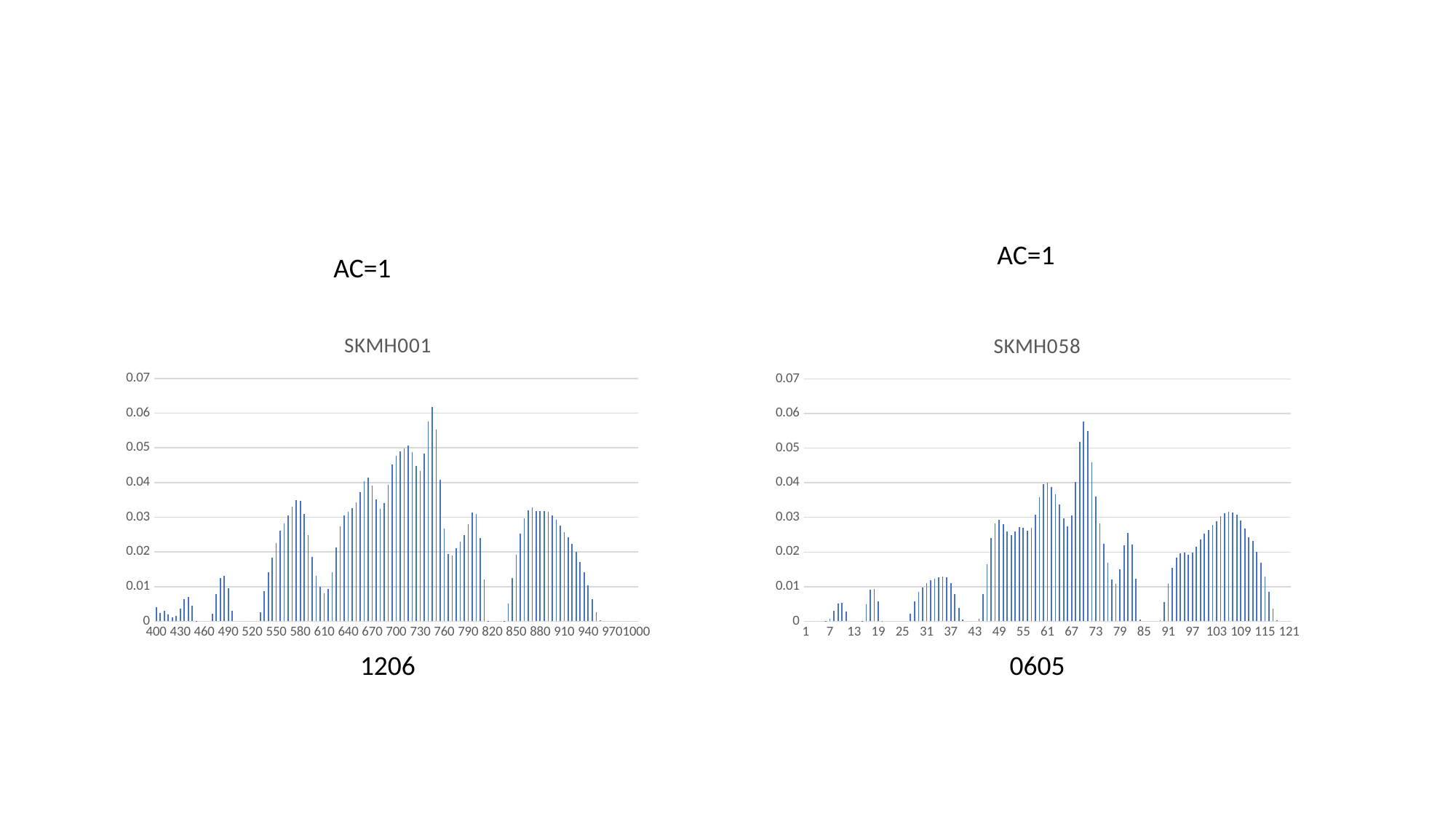
What kind of chart is the SKMH001 chart on the left? bar chart What is the highest value shown on the y axis of the SKMH001 chart? 0.07 Which chart has the taller maximum bar, SKMH001 or SKMH058? SKMH001 In the SKMH058 chart, is the value at 49 greater or less than 0.02? greater In the SKMH001 chart, is the value at 580 greater or less than 0.03? greater In the SKMH058 chart, is the value at 7 greater or less than 0.01? less What is the title of the chart on the right? SKMH058 What is the last label on the x axis of the SKMH058 chart? 121